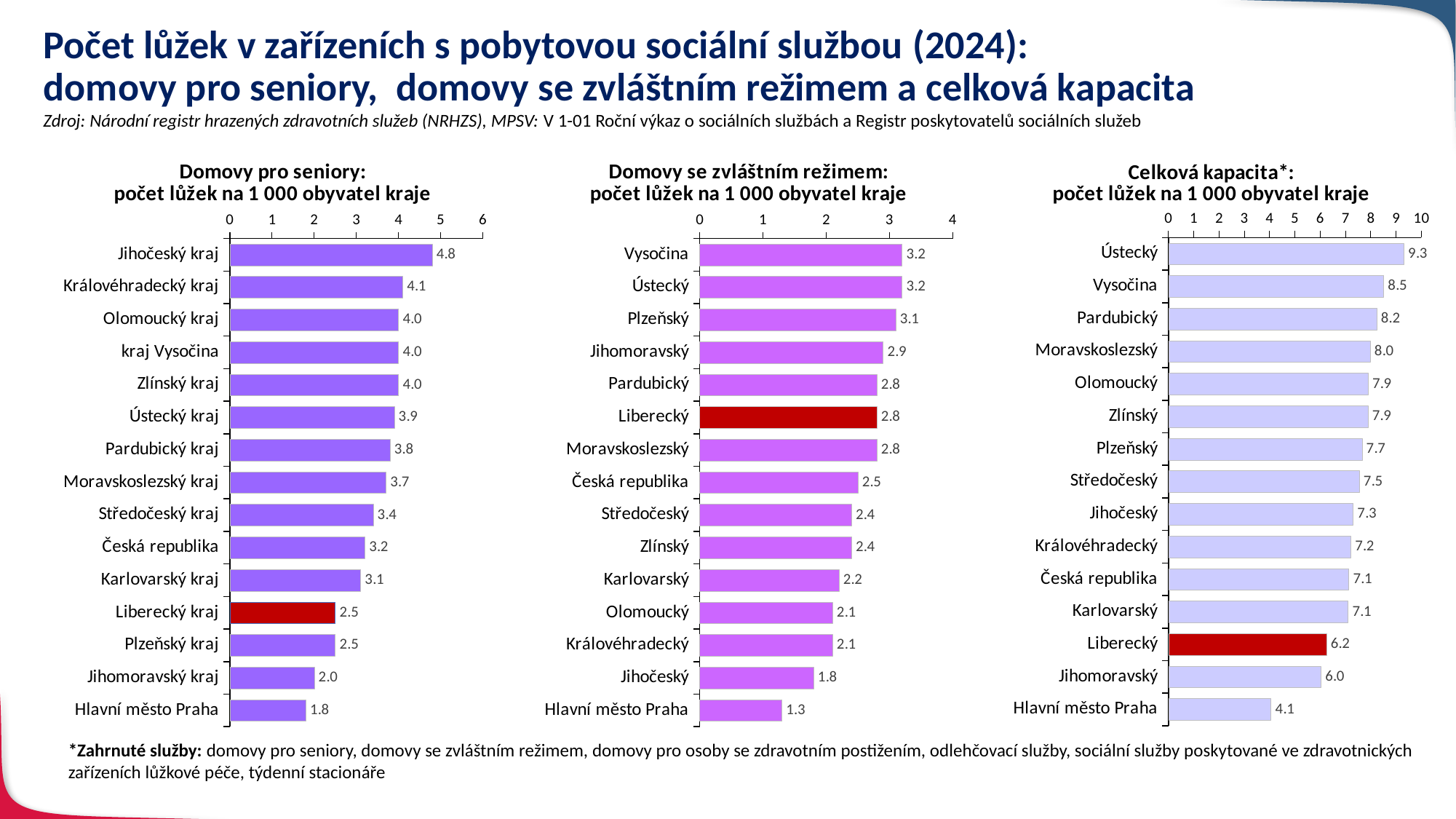
In the chart 'Celková kapacita*: počet lůžek na 1 000 obyvatel kraje', what is the difference between Ústecký and Hlavní město Praha? 5.2 In the chart 'Celková kapacita*: počet lůžek na 1 000 obyvatel kraje', which category has the highest value? Ústecký In the chart 'Domovy pro seniory: počet lůžek na 1 000 obyvatel kraje', which category has the lowest value? Hlavní město Praha In the chart 'Celková kapacita*: počet lůžek na 1 000 obyvatel kraje', which category's bar is highlighted in red? Liberecký In the chart 'Celková kapacita*: počet lůžek na 1 000 obyvatel kraje', what is the value for Liberecký? 6.2 How many categories are shown in the chart 'Celková kapacita*: počet lůžek na 1 000 obyvatel kraje'? 15 In the chart 'Domovy pro seniory: počet lůžek na 1 000 obyvatel kraje', what is the difference between Jihočeský kraj and Liberecký kraj? 2.3 In the chart 'Domovy se zvláštním režimem: počet lůžek na 1 000 obyvatel kraje', what is the value for Hlavní město Praha? 1.3 In the chart 'Domovy se zvláštním režimem: počet lůžek na 1 000 obyvatel kraje', which is larger, Plzeňský or Jihočeský? Plzeňský In the chart 'Domovy pro seniory: počet lůžek na 1 000 obyvatel kraje', what is the value for Jihočeský kraj? 4.8 In the chart 'Domovy se zvláštním režimem: počet lůžek na 1 000 obyvatel kraje', what is the value for Liberecký? 2.8 What kind of chart is 'Domovy pro seniory: počet lůžek na 1 000 obyvatel kraje'? Bar chart